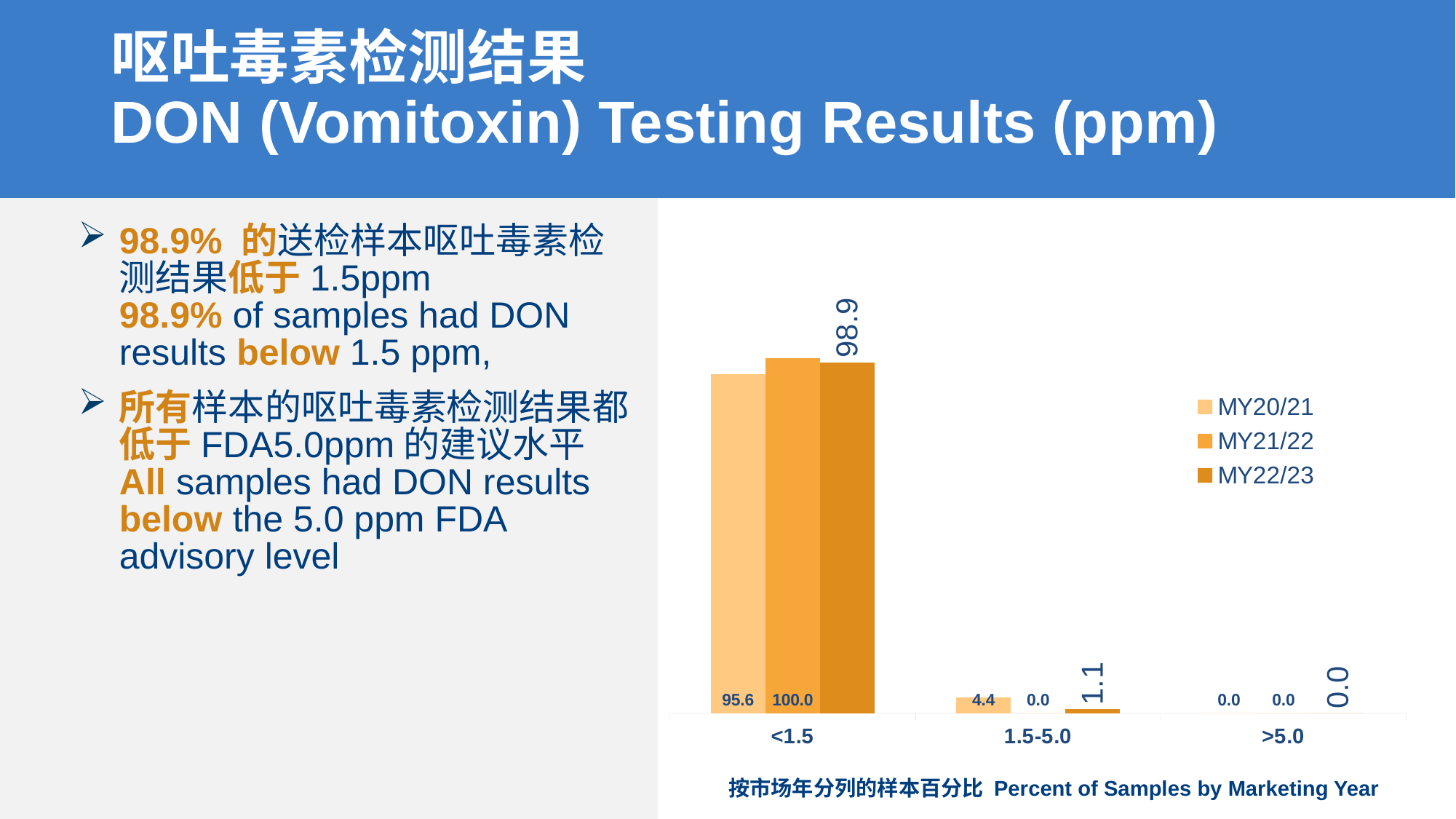
How many series does the legend list? 3 What is the value for MY21/22 in the >5.0 category? 0.0 What is the value for MY20/21 in the 1.5-5.0 category? 4.4 What is the difference between the MY21/22 and MY20/21 values in the <1.5 category? 4.4 What kind of chart is shown on the slide? Bar chart Which series has the highest value in the <1.5 category? MY21/22 What is the value for MY22/23 in the 1.5-5.0 category? 1.1 What is the value for MY21/22 in the <1.5 category? 100.0 What is the value for MY22/23 in the <1.5 category? 98.9 Which is larger in the 1.5-5.0 category, MY20/21 or MY22/23? MY20/21 How many categories are shown on the x axis? 3 What is the value for MY20/21 in the <1.5 category? 95.6